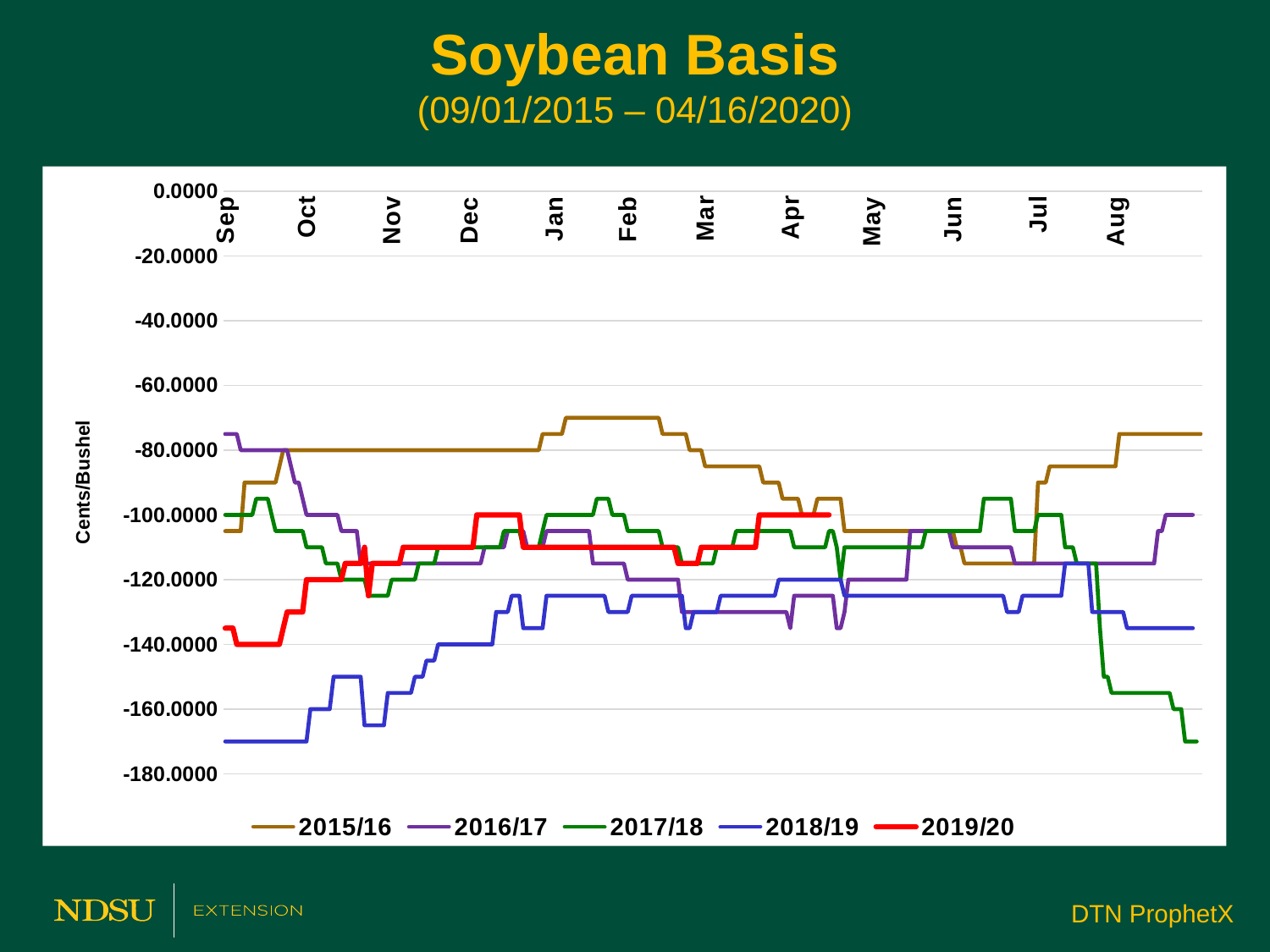
Does the 2018/19 line rise or fall from Sep to Jan? rise Which series is drawn in red? 2019/20 Which series has the lowest value in Sep? 2018/19 How many months are labelled along the x axis? 12 Is the value for 2018/19 in Sep greater or less than -160? less Which series has the highest value in Feb? 2015/16 How many series does the legend list? 5 Is the value for 2015/16 in Feb greater or less than -80? greater Is the value for 2018/19 in Jan greater or less than -100? less What is the label on the y axis? Cents/Bushel What kind of chart is shown on the slide? line chart